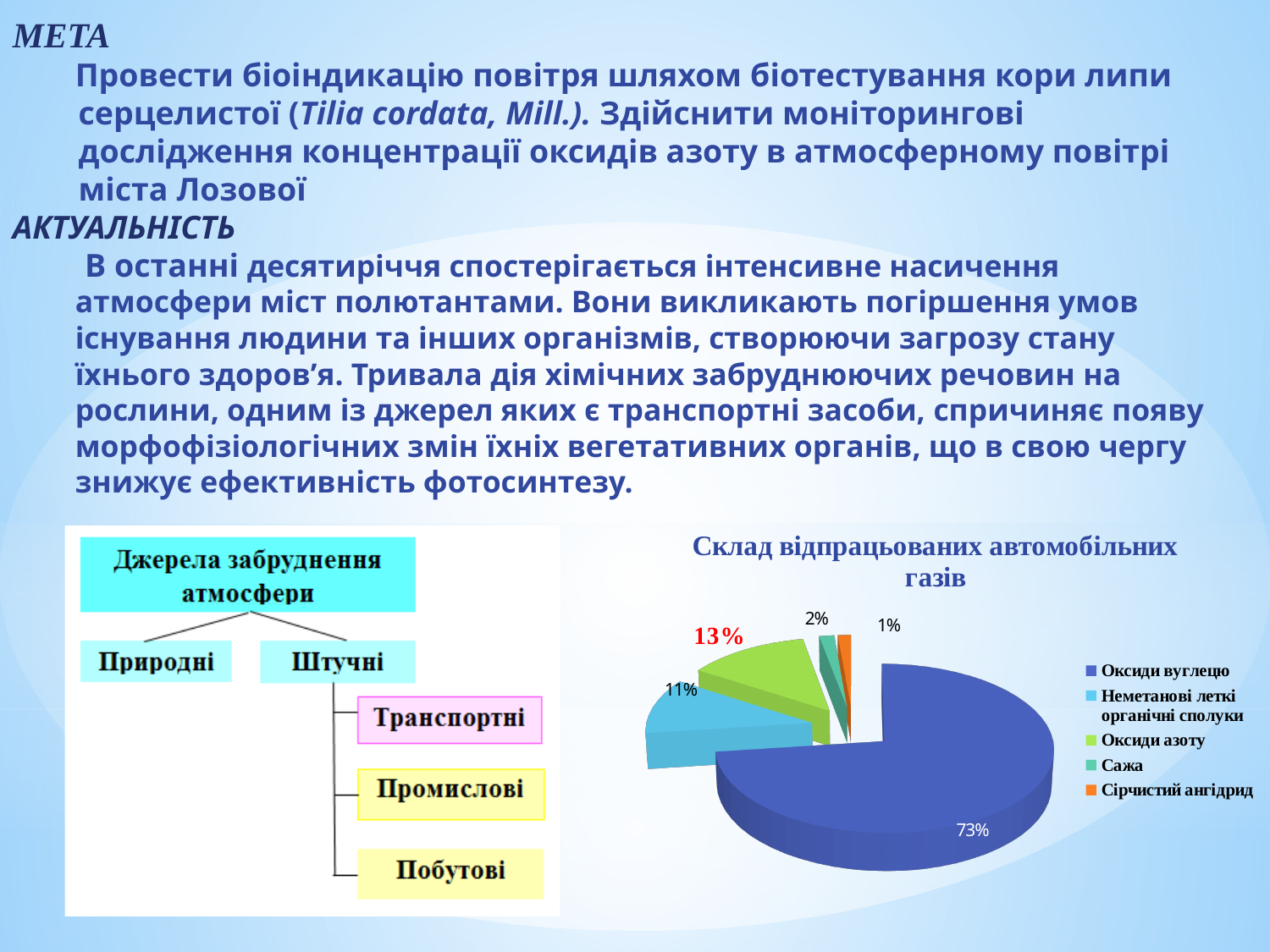
Which category has the smallest slice of the pie? Сірчистий ангідрид What share of the pie does Сажа have? 2% What is the title of the pie chart? Склад відпрацьованих автомобільних газів What share of the pie does Неметанові леткі органічні сполуки have? 11% Which category has the largest slice of the pie? Оксиди вуглецю How many categories does the legend of the pie chart list? 5 What share of the pie does Сірчистий ангідрид have? 1% What type of chart is shown on the slide? Pie chart What is the difference between the shares of Оксиди вуглецю and Оксиди азоту? 60% Which is larger, the share of Оксиди азоту or the share of Неметанові леткі органічні сполуки? Оксиди азоту